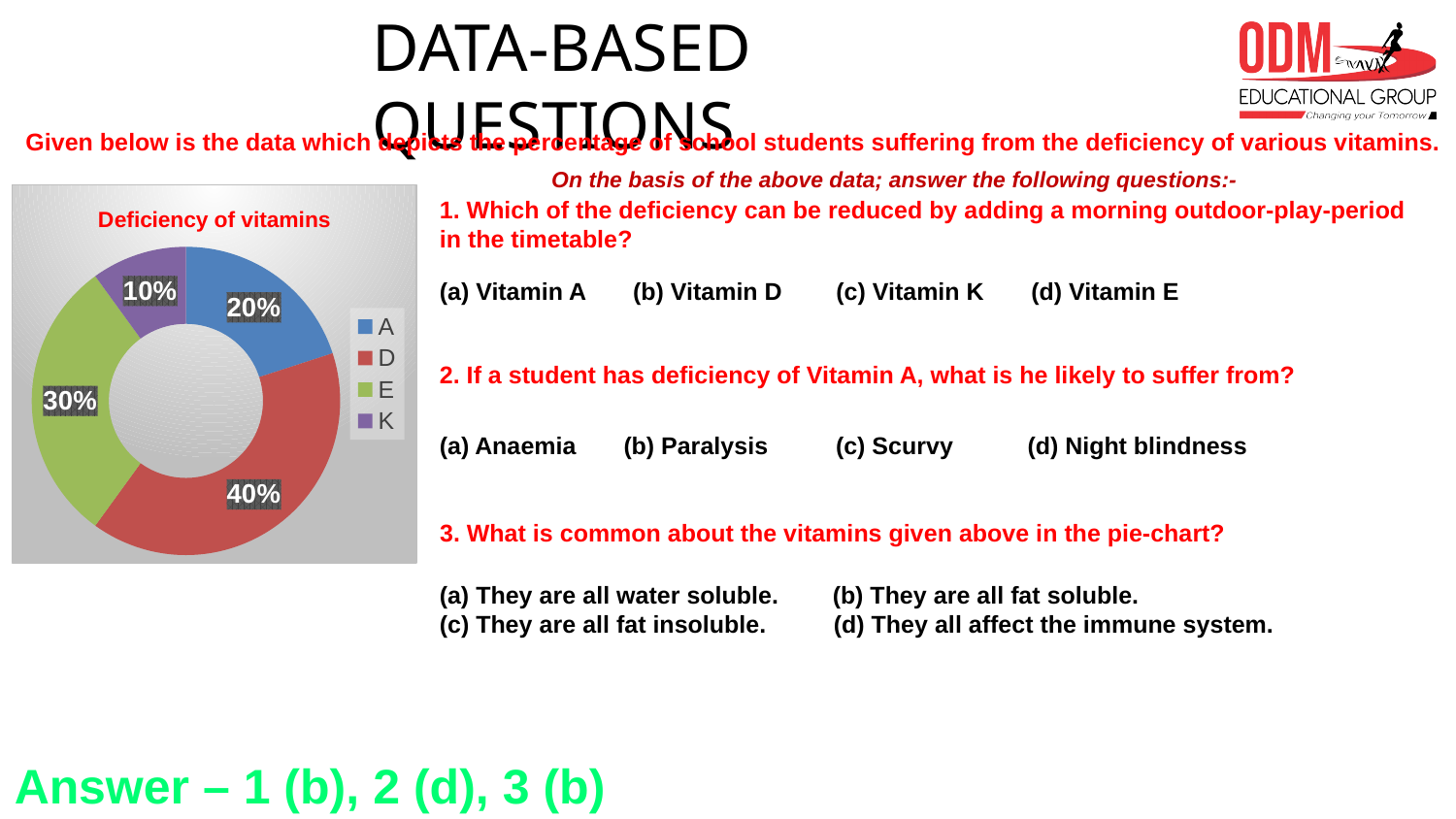
Which vitamin is represented by the green segment in the chart? E What is the difference in percentage points between the vitamin D and vitamin E deficiency shares? 10 What is the difference in percentage points between the vitamin A and vitamin K deficiency shares? 10 What kind of chart is used to show the deficiency of vitamins? Doughnut (pie) chart What is the title of the chart? Deficiency of vitamins Which vitamin deficiency has the largest share in the chart? D Which has a larger share in the chart, vitamin E deficiency or vitamin A deficiency? E What percentage of students have a deficiency of vitamin D according to the chart? 40% What percentage of students have a deficiency of vitamin A according to the chart? 20% How many vitamin categories are shown in the chart? 4 What percentage of students have a deficiency of vitamin K according to the chart? 10% Which vitamin deficiency has the smallest share in the chart? K